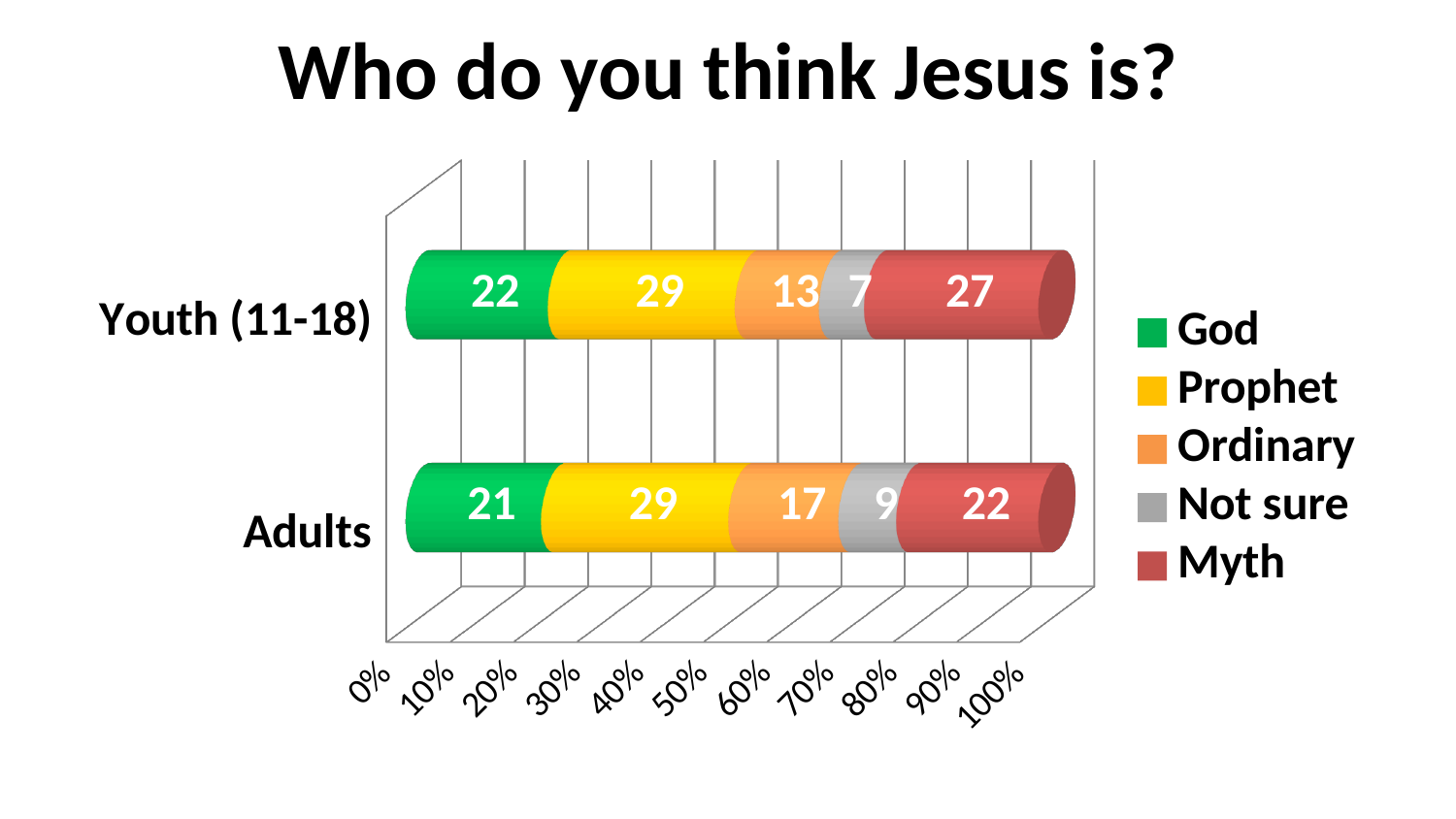
Which is larger: the Ordinary value for Youth (11-18) or for Adults? Adults How many series does the legend list? 5 What is the title of the chart? Who do you think Jesus is? Which series has the highest value in the Adults bar? Prophet What is the value for Prophet in the Youth (11-18) bar? 29 What is the difference between the Myth values for Youth (11-18) and Adults? 5 What is the value for Not sure in the Adults bar? 9 What is the value for God in the Adults bar? 21 What is the value for Myth in the Youth (11-18) bar? 27 What kind of chart is shown on the slide? Stacked bar chart Which series has the lowest value in the Youth (11-18) bar? Not sure How many categories are shown on the chart? 2